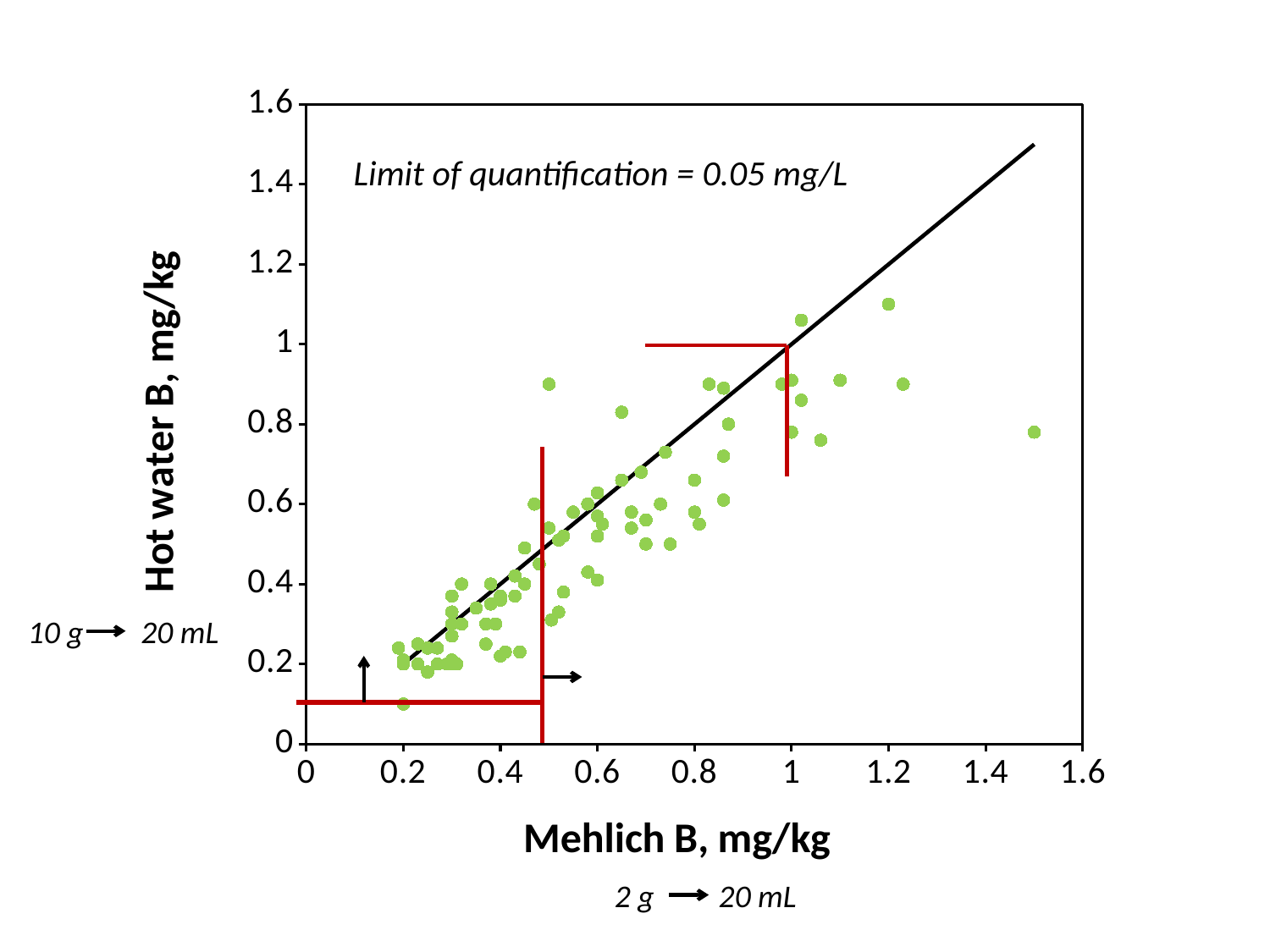
What is the title of the x axis? Mehlich B, mg/kg Is the hot water B value for the point with the largest Mehlich B value (near 1.5 mg/kg) greater or less than 1? less Is the hot water B value for the point at about 1.2 mg/kg Mehlich B greater or less than 1? greater What is the maximum value shown on the y axis? 1.6 What limit of quantification is stated on the chart? 0.05 mg/L What kind of chart is shown on the slide? Scatter plot Is the hot water B value for the lowest point on the chart (near 0.2 mg/kg Mehlich B) greater or less than 0.2? less Do the hot water B values generally rise or fall as Mehlich B increases along the x axis? Rise What is the title of the y axis? Hot water B, mg/kg What is the maximum value shown on the x axis? 1.6